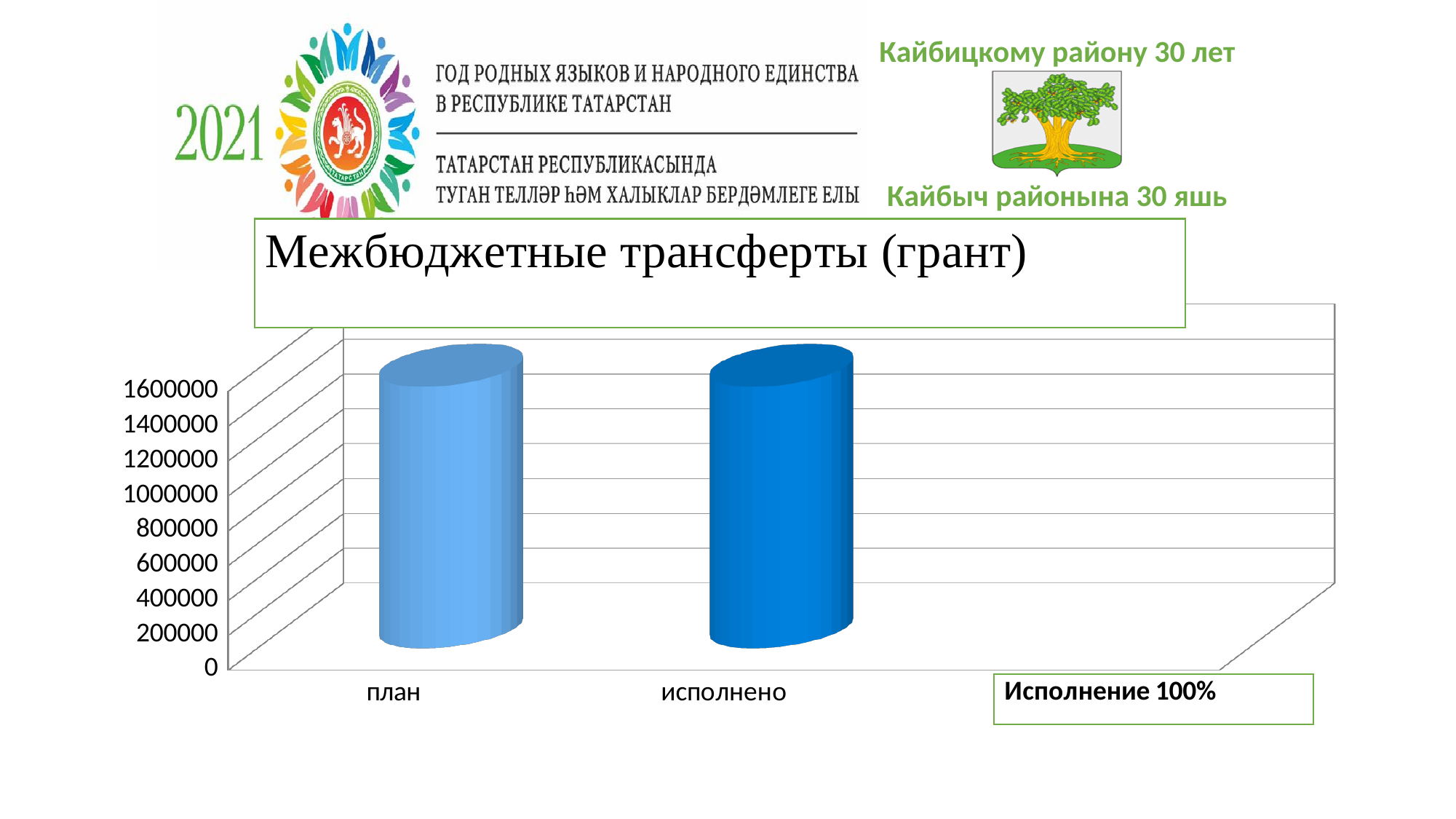
What are the two category labels on the x axis of the chart? план, исполнено Is the value for исполнено greater or less than 1200000? greater How many categories are plotted on the x axis of the chart? 2 What kind of chart is shown on the slide? bar chart Is the value for план greater or less than 800000? greater Is the value for исполнено greater or less than 600000? greater What is the title of the chart? Межбюджетные трансферты (грант) What is the lowest tick value shown on the vertical axis of the chart? 0